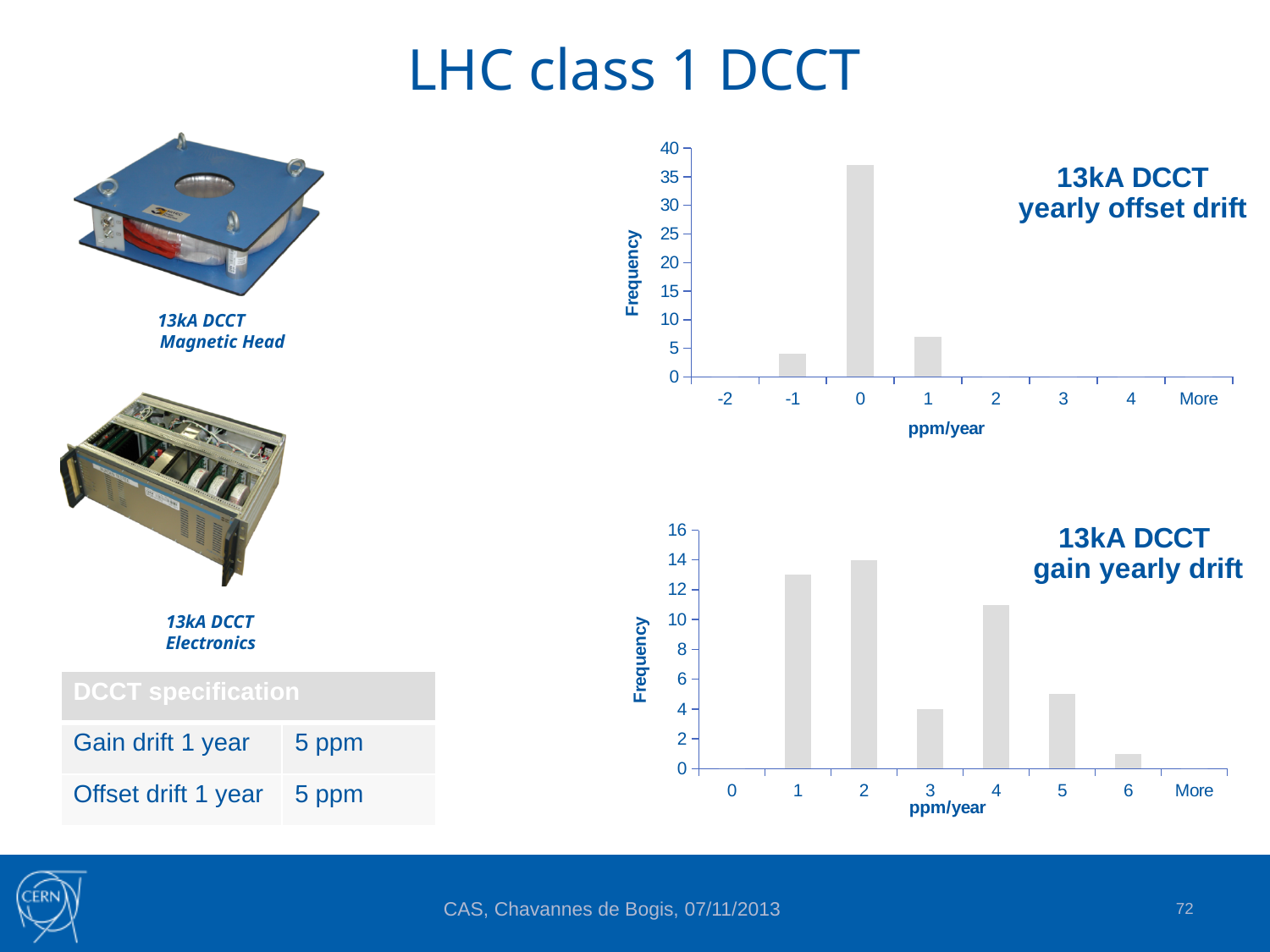
In the '13kA DCCT gain yearly drift' chart, which ppm/year category has the highest frequency? 2 In the '13kA DCCT yearly offset drift' chart, how many categories are shown on the x axis? 8 In the '13kA DCCT yearly offset drift' chart, is the frequency for the 1 ppm/year category greater or less than 10? less In the '13kA DCCT gain yearly drift' chart, which has the higher frequency, the 1 or the 5 ppm/year category? 1 In the '13kA DCCT yearly offset drift' chart, which ppm/year category has the highest frequency? 0 In the '13kA DCCT gain yearly drift' chart, is the frequency for the 4 ppm/year category greater or less than 10? greater In the '13kA DCCT yearly offset drift' chart, is the frequency for the 0 ppm/year category greater or less than 35? greater In the '13kA DCCT gain yearly drift' chart, what is the frequency for the 3 ppm/year category? 4 In the '13kA DCCT yearly offset drift' chart, which has the higher frequency, the -1 or the 1 ppm/year category? 1 In the '13kA DCCT gain yearly drift' chart, what is the label of the y axis? Frequency In the '13kA DCCT gain yearly drift' chart, what is the frequency for the 2 ppm/year category? 14 In the '13kA DCCT yearly offset drift' chart, what kind of chart is shown? bar chart